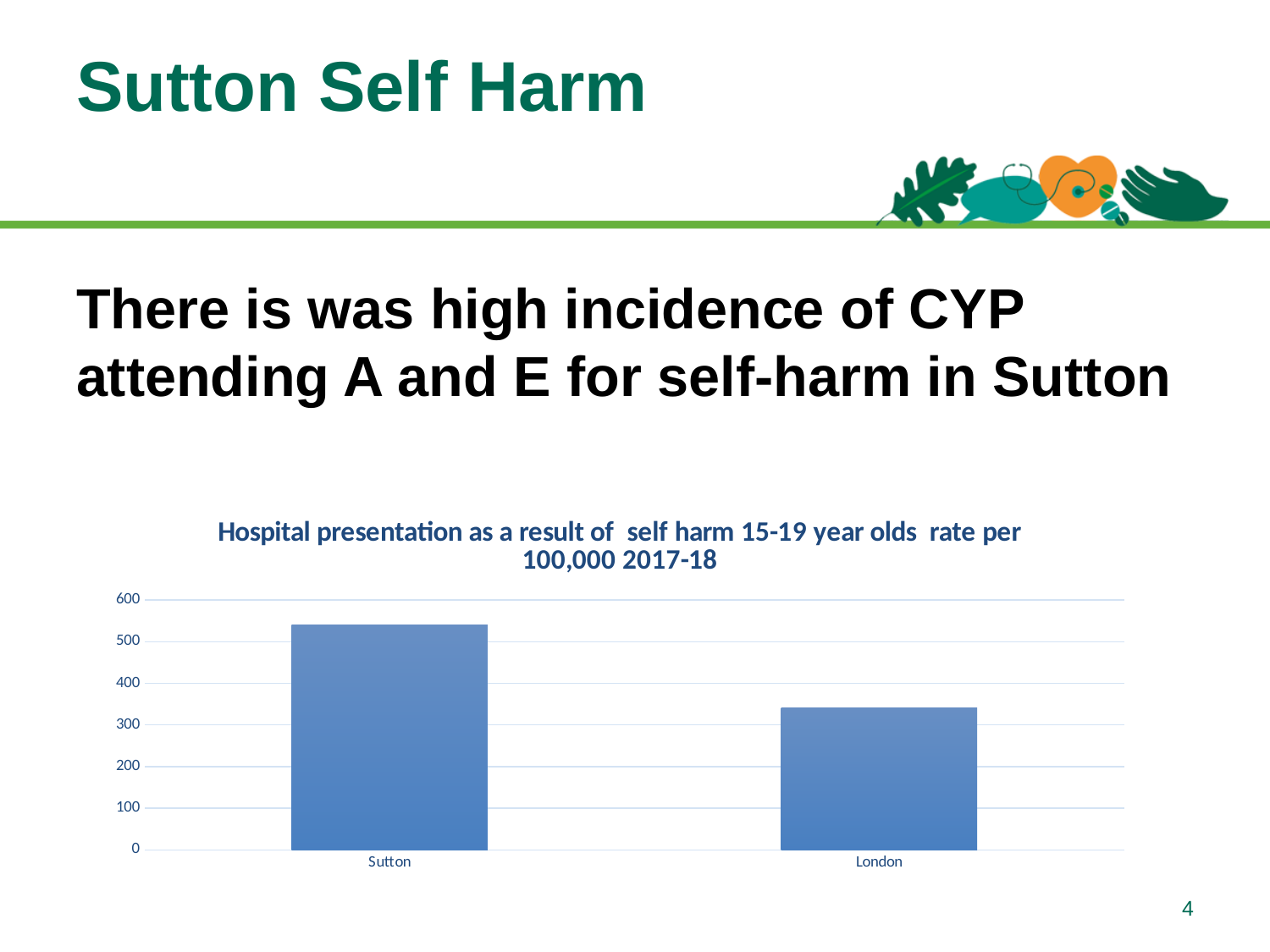
Which category has the lowest value in the chart? London Is the value for Sutton greater or less than 600? less Is the value for London greater or less than 400? less Which category has the highest value in the chart? Sutton How many categories are plotted in the chart? 2 What kind of chart is shown on the slide? bar chart Which has a larger value, Sutton or London? Sutton Is the value for Sutton greater or less than 500? greater What is the highest value shown on the vertical axis of the chart? 600 What is the title of the chart? Hospital presentation as a result of self harm 15-19 year olds rate per 100,000 2017-18